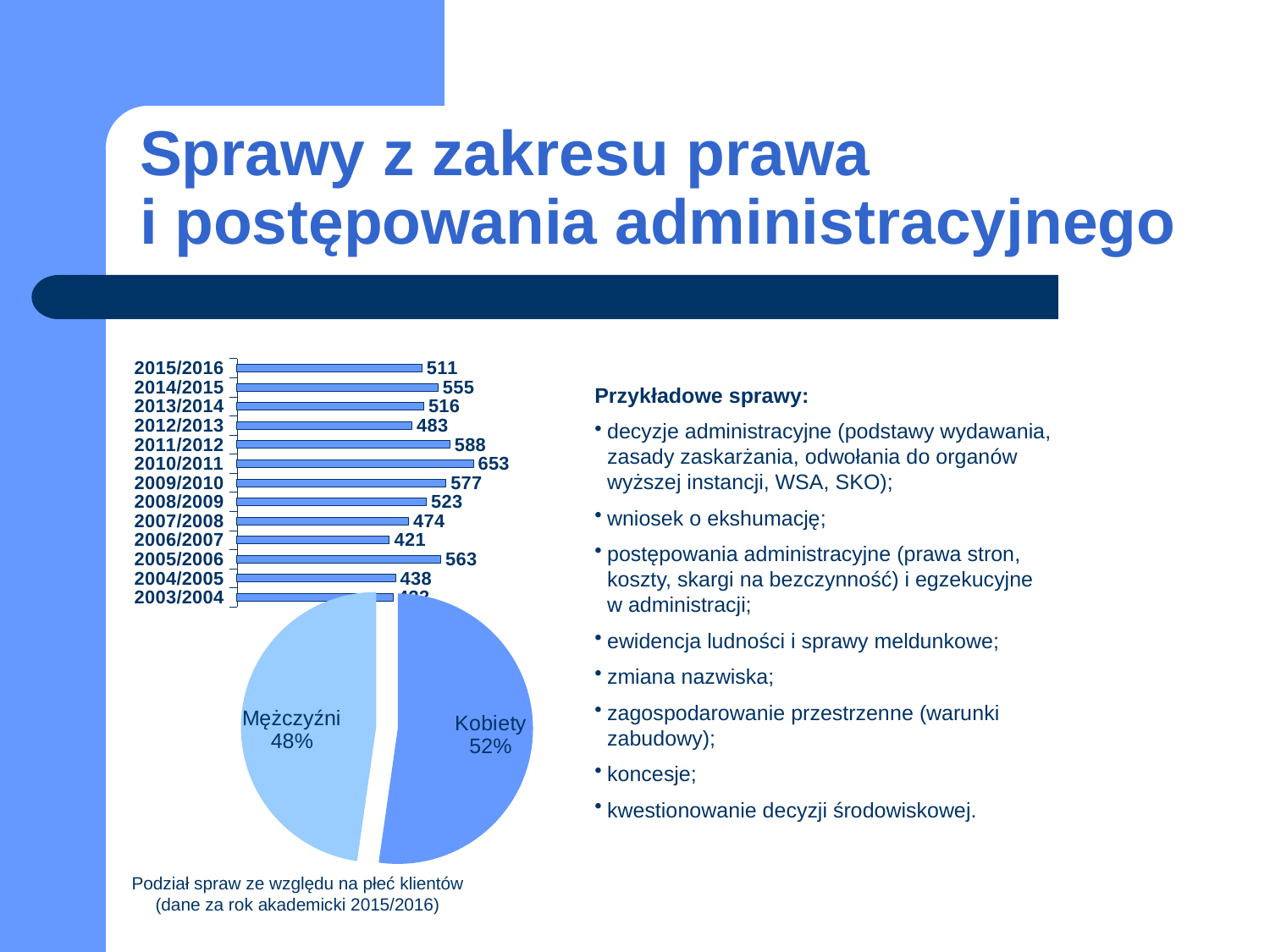
In the bar chart, what is the value for 2010/2011? 653 In the bar chart, which is larger: the value for 2011/2012 or the value for 2009/2010? 2011/2012 In the bar chart, which academic year has the highest value? 2010/2011 In the bar chart, what is the value for 2015/2016? 511 In the bar chart, how many academic years are shown? 13 In the bar chart, what is the difference between the values for 2014/2015 and 2013/2014? 39 What kind of chart shows the values by academic year? Bar chart In the bar chart, what is the value for 2006/2007? 421 In the pie chart, what share is labelled Mężczyźni? 48% In the pie chart, which slice is larger: Kobiety or Mężczyźni? Kobiety What is the caption below the pie chart? Podział spraw ze względu na płeć klientów (dane za rok akademicki 2015/2016) In the pie chart, what share is labelled Kobiety? 52%